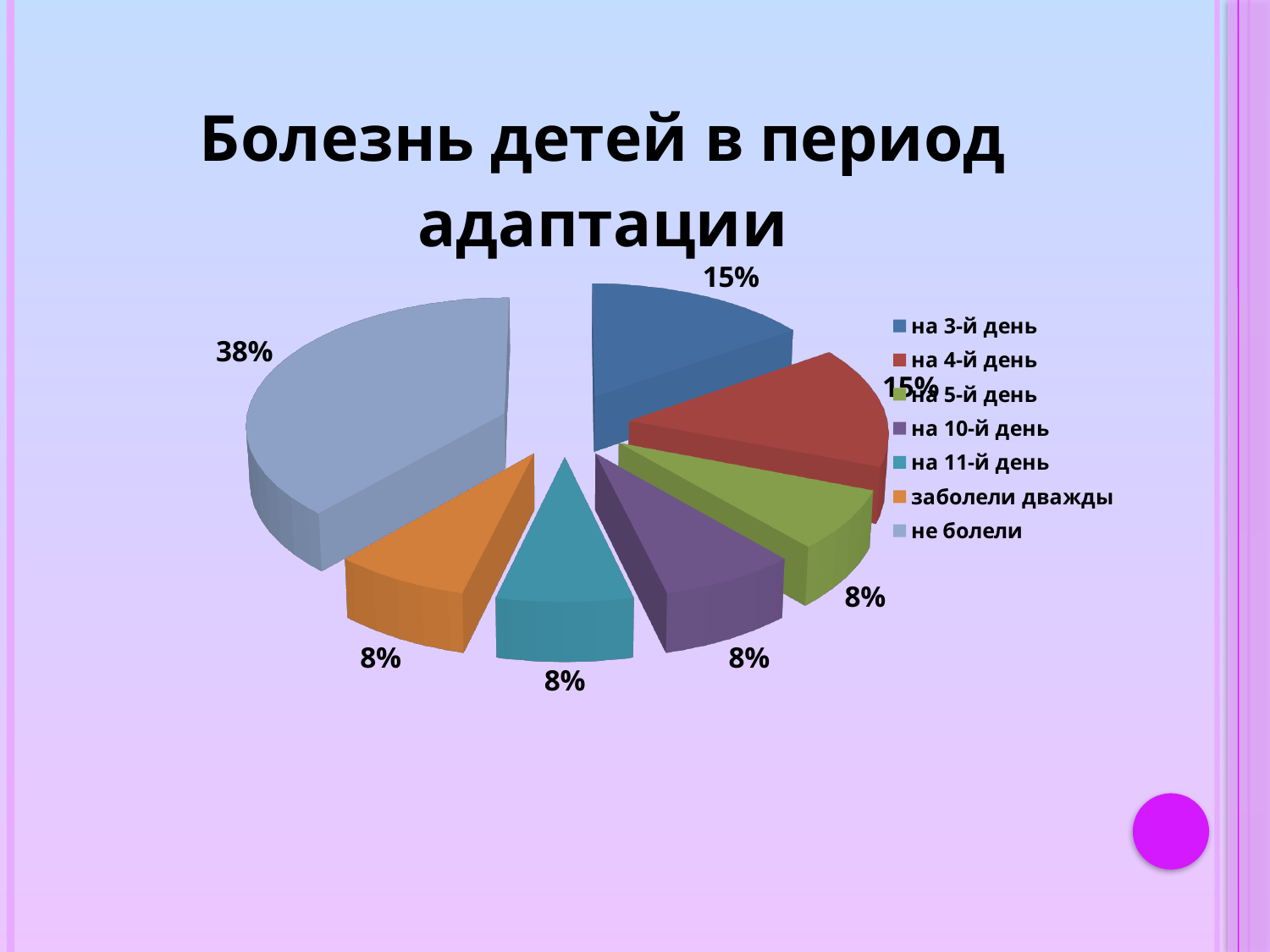
What is the difference between the share for "не болели" and the share for "на 4-й день"? 23% Which is larger, the slice for "не болели" or the slice for "на 3-й день"? не болели What is the title of the chart? Болезнь детей в период адаптации Which category has the largest slice of the pie? не болели What share of the pie is labelled for "на 10-й день"? 8% What share of the pie is labelled for "заболели дважды"? 8% What share of the pie is labelled for "не болели"? 38% What share of the pie is labelled for "на 3-й день"? 15% What share of the pie is labelled for "на 4-й день"? 15% What kind of chart is shown on the slide? pie chart How many categories does the legend list? 7 Which colour represents "не болели" in the legend? light blue-grey